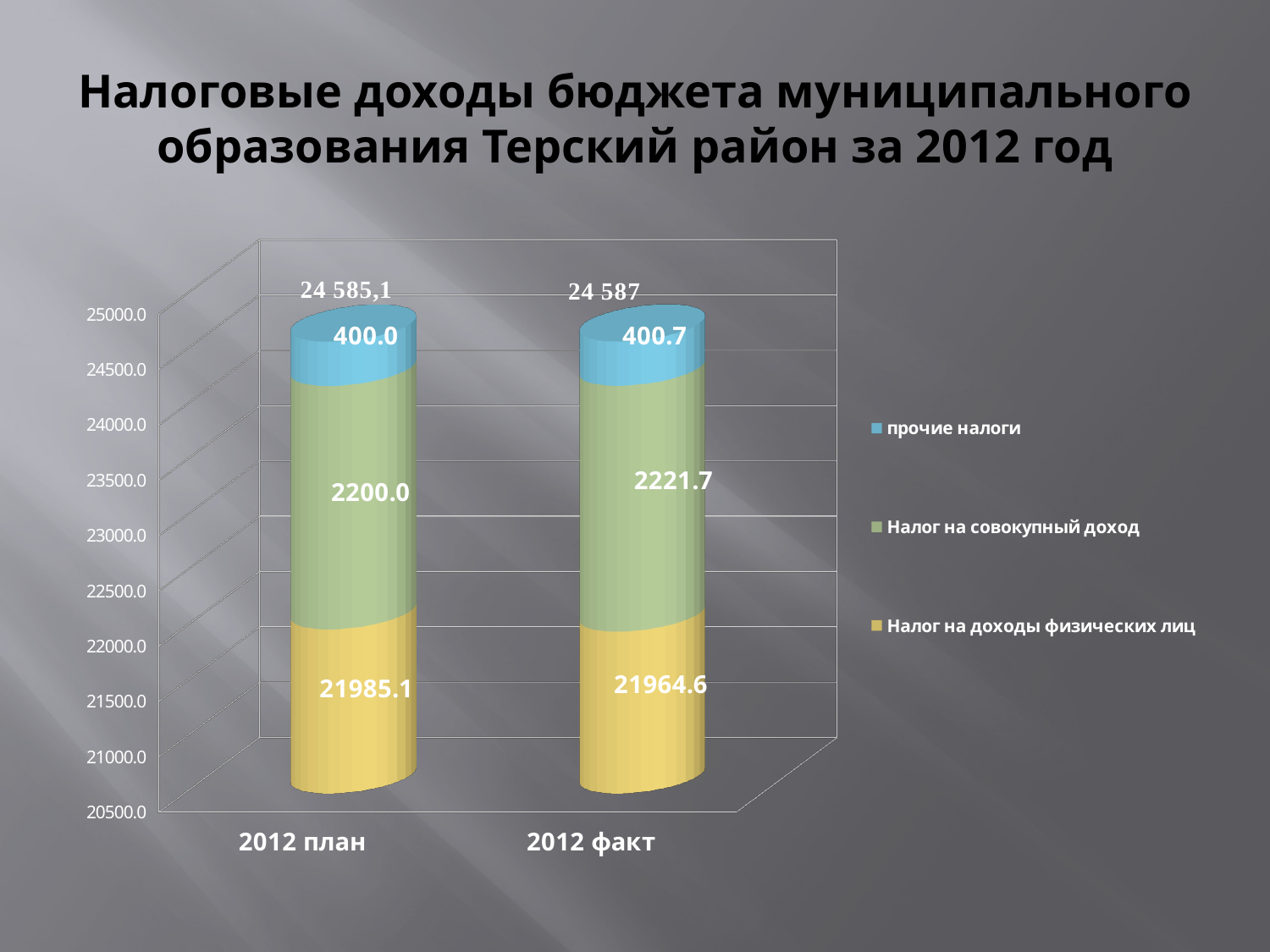
Which is larger: Налог на доходы физических лиц for 2012 план or for 2012 факт? 2012 план How many categories are shown on the x axis? 2 What is the value of прочие налоги for 2012 факт? 400.7 What is the value of Налог на совокупный доход for 2012 факт? 2221.7 Which series is shown in blue in the legend? прочие налоги What is the total printed above the 2012 план bar? 24 585,1 How many series does the legend list? 3 What is the value of прочие налоги for 2012 план? 400.0 What is the value of Налог на доходы физических лиц for 2012 план? 21985.1 What kind of chart is shown on the slide? Stacked bar chart What is the difference between Налог на совокупный доход for 2012 факт and 2012 план? 21.7 What is the total printed above the 2012 факт bar? 24 587